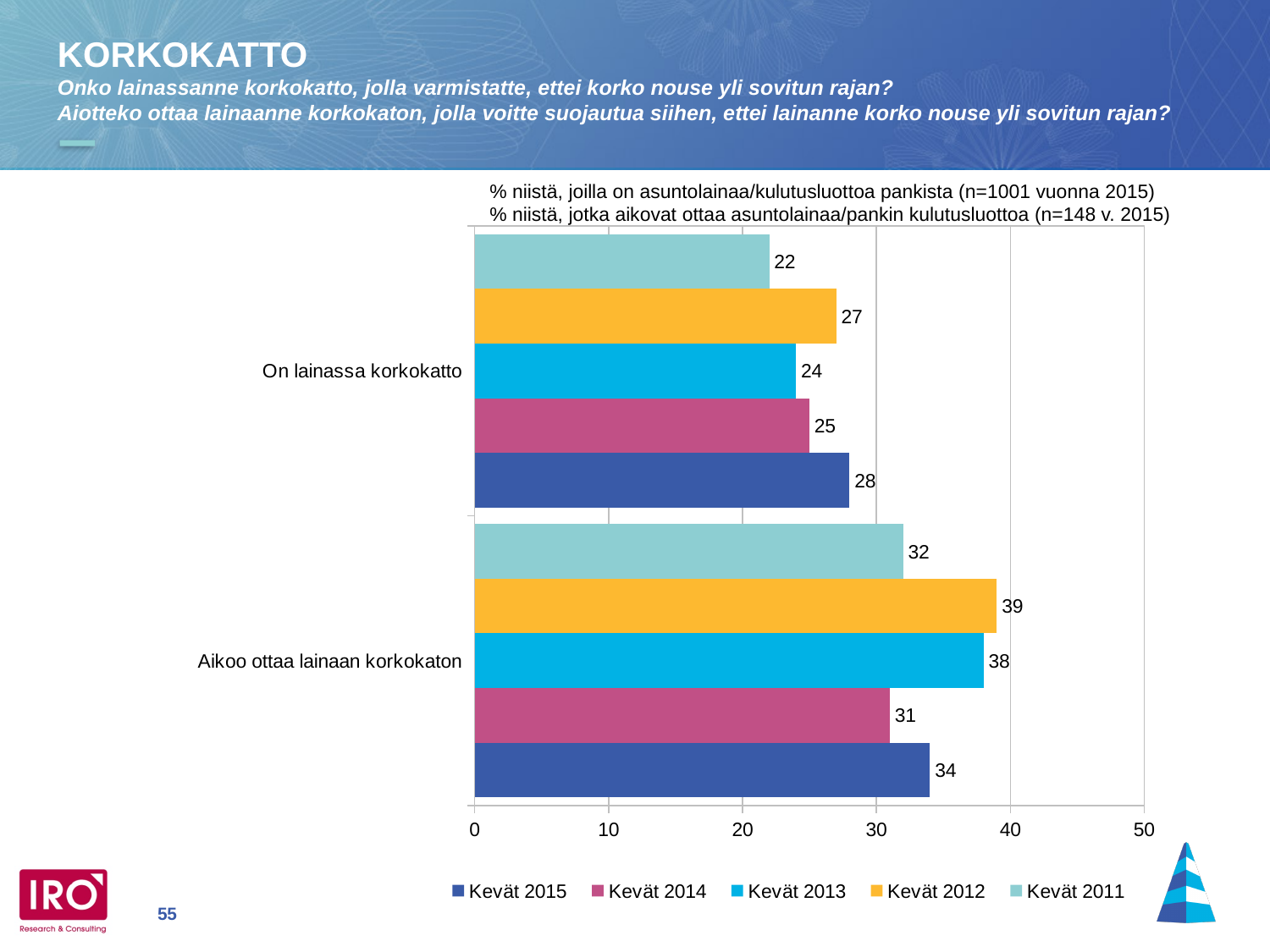
What is the difference between the Kevät 2015 values for "Aikoo ottaa lainaan korkokaton" and "On lainassa korkokatto"? 6 What is the maximum value shown on the horizontal axis? 50 Which series has the lowest value in the "On lainassa korkokatto" category? Kevät 2011 How many series does the legend list? 5 What is the value for Kevät 2015 in the "On lainassa korkokatto" category? 28 What kind of chart is shown on the slide? Bar chart What is the value for Kevät 2011 in the "On lainassa korkokatto" category? 22 How many categories are shown on the chart? 2 Which series has the highest value in the "Aikoo ottaa lainaan korkokaton" category? Kevät 2012 Which is larger in the "Aikoo ottaa lainaan korkokaton" category: Kevät 2014 or Kevät 2013? Kevät 2013 Is the Kevät 2012 value for "Aikoo ottaa lainaan korkokaton" greater or less than 30? greater What is the value for Kevät 2012 in the "Aikoo ottaa lainaan korkokaton" category? 39